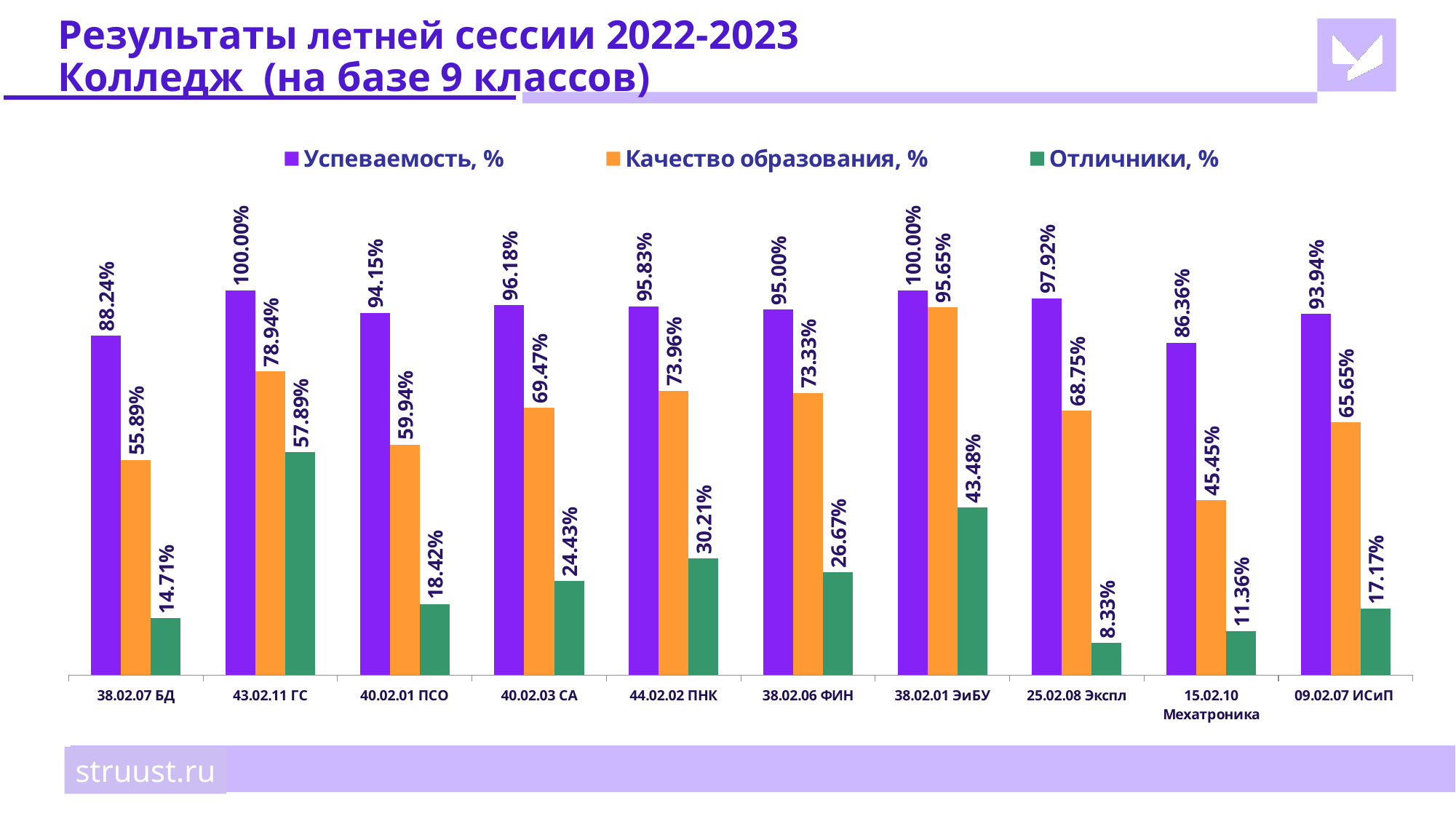
Which is larger: Отличники, % for 44.02.02 ПНК or for 38.02.06 ФИН? 44.02.02 ПНК What type of chart is shown on the slide? Bar chart What colour are the bars for the Качество образования, % series? Orange What is the value of Отличники, % for 09.02.07 ИСиП? 17.17% Which category has the lowest value of Отличники, %? 25.02.08 Экспл What is the difference between Качество образования, % for 38.02.01 ЭиБУ and for 15.02.10 Мехатроника? 50.20% Which category has the highest value of Отличники, %? 43.02.11 ГС Which category has the lowest value of Успеваемость, %? 15.02.10 Мехатроника What is the value of Качество образования, % for 44.02.02 ПНК? 73.96% What is the value of Успеваемость, % for 38.02.07 БД? 88.24% How many categories (specialties) are shown on the x axis? 10 How many series does the legend list? 3